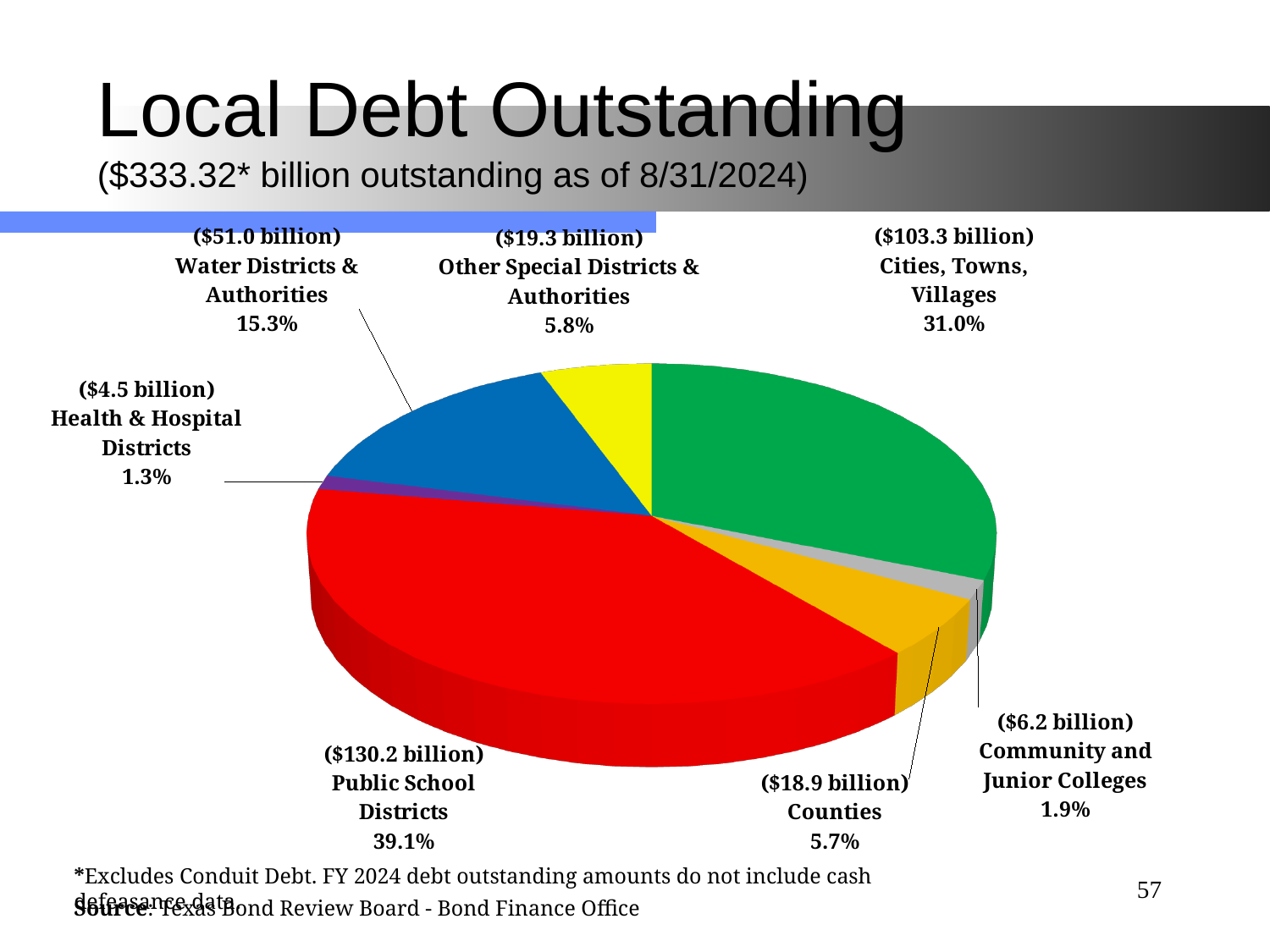
What is the dollar amount of debt outstanding for Cities, Towns, Villages? $103.3 billion Which category has the largest share of local debt outstanding? Public School Districts Which category has the smallest share of local debt outstanding? Health & Hospital Districts Which has a larger share of local debt outstanding, Counties or Other Special Districts & Authorities? Other Special Districts & Authorities What is the total local debt outstanding stated in the slide subtitle? $333.32* billion What is the dollar amount of debt outstanding for Water Districts & Authorities? $51.0 billion What kind of chart is shown on the slide? Pie chart What colour is the slice for Cities, Towns, Villages? Green What is the difference in percentage points between the Public School Districts share and the Cities, Towns, Villages share? 8.1 What share of local debt outstanding is held by Public School Districts? 39.1% What share of local debt outstanding is held by Community and Junior Colleges? 1.9% How many categories are shown in the pie chart? 7